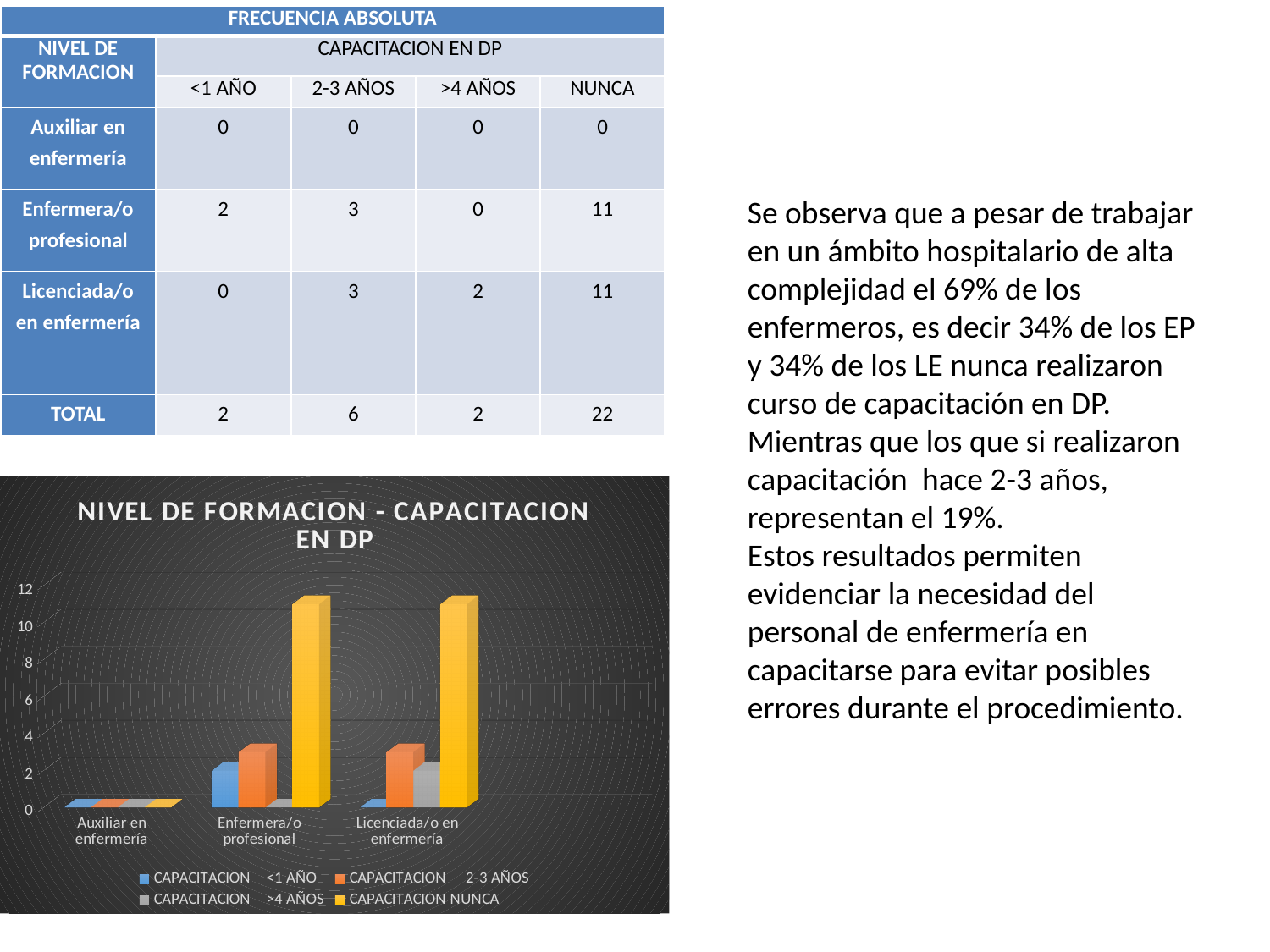
Is the CAPACITACION 2-3 AÑOS value for Enfermera/o profesional greater or less than 4? less How many categories are shown on the x axis of the chart? 3 What is the CAPACITACION >4 AÑOS value for Licenciada/o en enfermería? 2 For Licenciada/o en enfermería, what is the difference between the CAPACITACION NUNCA value and the CAPACITACION 2-3 AÑOS value? 8 Which category has the lowest bars across all series in the chart? Auxiliar en enfermería What is the title of the chart? NIVEL DE FORMACION - CAPACITACION EN DP What kind of chart is shown on the slide? bar chart Is the CAPACITACION NUNCA value for Licenciada/o en enfermería greater or less than 10? greater What is the CAPACITACION NUNCA value for Enfermera/o profesional? 11 Which category has the larger CAPACITACION <1 AÑO value, Enfermera/o profesional or Licenciada/o en enfermería? Enfermera/o profesional Which series has the tallest bar for Enfermera/o profesional? CAPACITACION NUNCA How many series does the chart legend list? 4